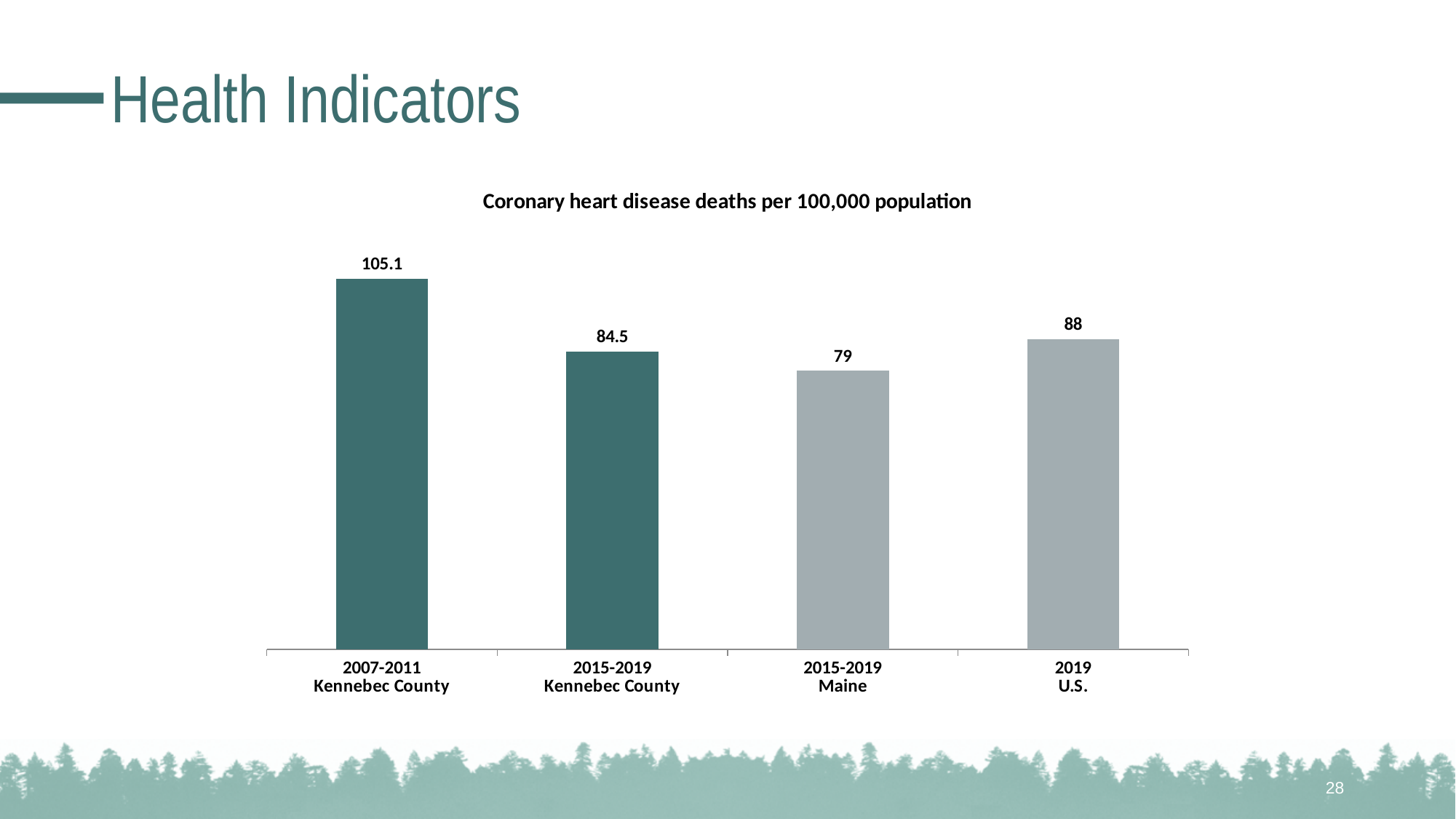
What is the title of the chart? Coronary heart disease deaths per 100,000 population Which is larger, the value for 2015-2019 Kennebec County or the value for 2019 U.S.? 2019 U.S. What is the value for 2019 U.S.? 88 What is the value for 2015-2019 Kennebec County? 84.5 Which category has the lowest value? 2015-2019 Maine What is the difference between the 2007-2011 Kennebec County value and the 2015-2019 Kennebec County value? 20.6 How many bars are shown in the chart? 4 Which category has the highest value? 2007-2011 Kennebec County What kind of chart is shown on the slide? Bar chart What is the value for 2015-2019 Maine? 79 What is the difference between the 2019 U.S. value and the 2015-2019 Maine value? 9 What is the value for 2007-2011 Kennebec County? 105.1